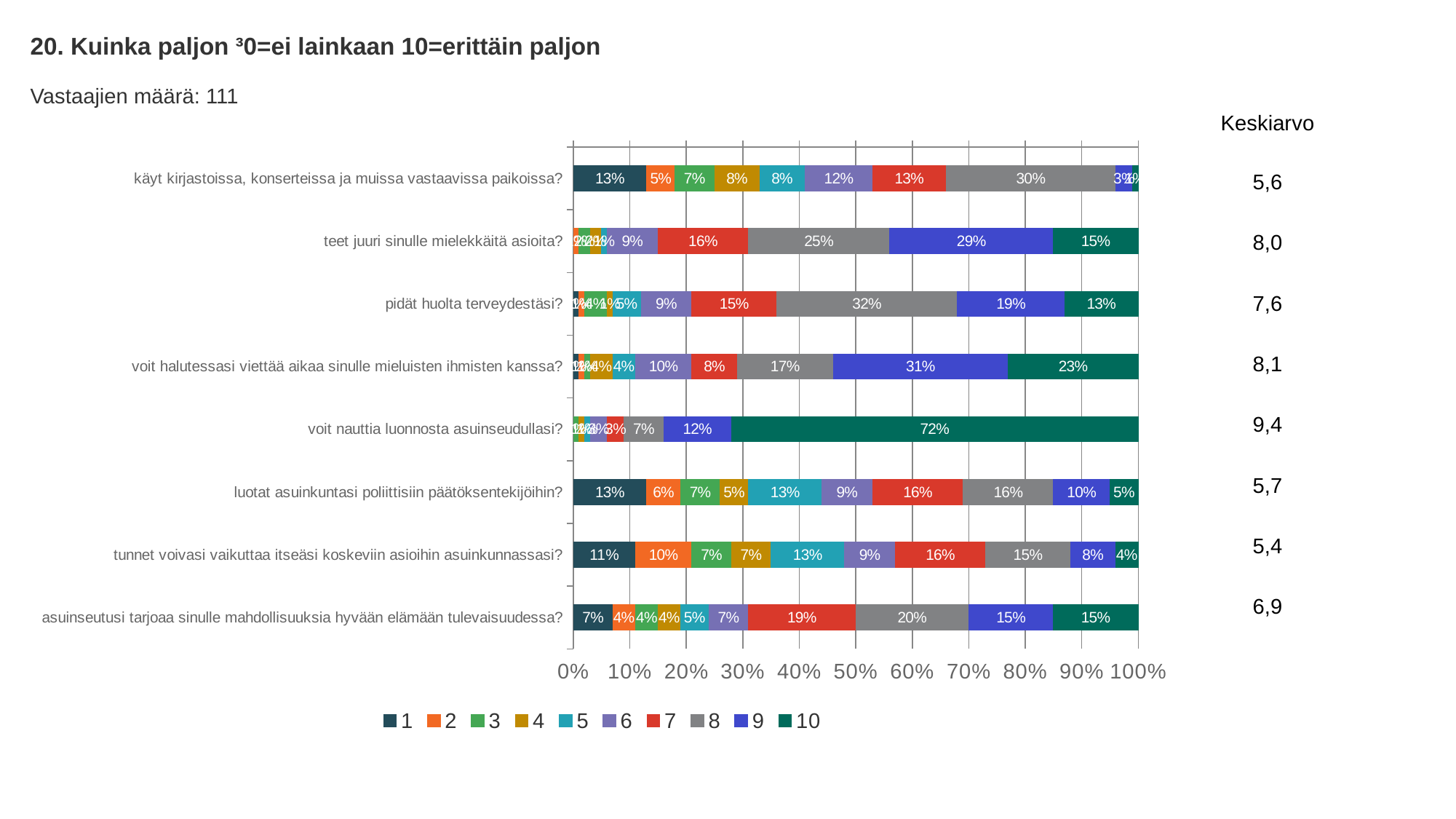
What percentage gave a rating of 8 for 'asuinseutusi tarjoaa sinulle mahdollisuuksia hyvään elämään tulevaisuudessa?' 20% What kind of chart is shown on the slide? Stacked bar chart For 'luotat asuinkuntasi poliittisiin päätöksentekijöihin?', what is the difference in percentage points between the share rating 7 and the share rating 2? 10 percentage points How many series does the legend list? 10 What percentage of respondents gave a rating of 10 for 'voit nauttia luonnosta asuinseudullasi?' 72% What percentage gave a rating of 8 for 'pidät huolta terveydestäsi?' 32% Which category has the largest share of respondents giving a rating of 10? voit nauttia luonnosta asuinseudullasi? How many question categories (bars) are shown in the chart? 8 What percentage gave a rating of 8 for 'käyt kirjastoissa, konserteissa ja muissa vastaavissa paikoissa?' 30% What is the Keskiarvo (average) shown for 'voit nauttia luonnosta asuinseudullasi?' 9,4 What percentage gave a rating of 5 for 'tunnet voivasi vaikuttaa itseäsi koskeviin asioihin asuinkunnassasi?' 13% For 'teet juuri sinulle mielekkäitä asioita?', which rating has a larger share: 9 or 10? 9